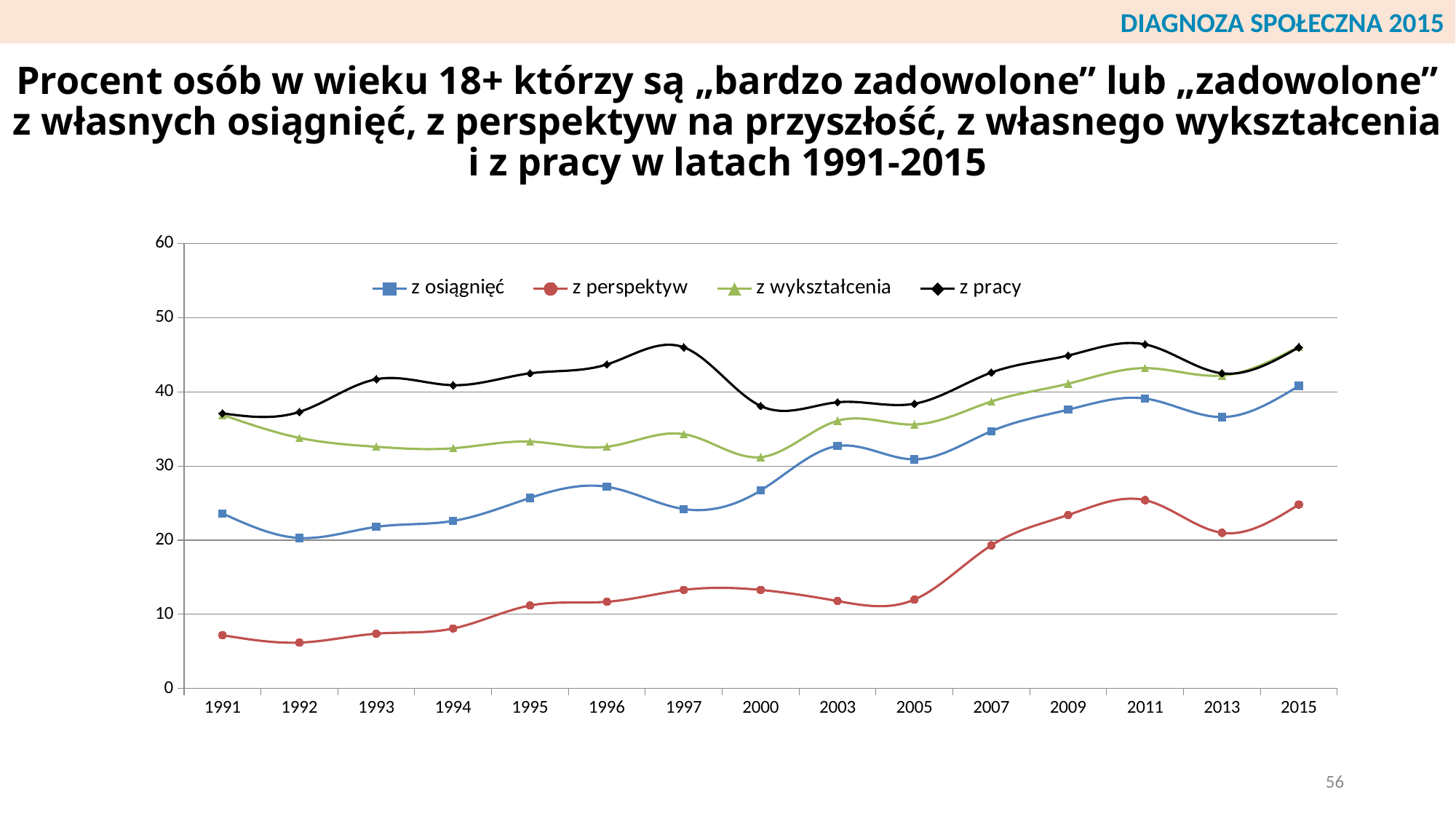
How many years are plotted along the x axis? 15 Does the value for "z perspektyw" rise or fall between 2005 and 2011? rise Which series is drawn with a black line and diamond markers? z pracy Is the value for "z perspektyw" in 2011 greater or less than 20? greater In 1995, which is larger: the value for "z wykształcenia" or the value for "z osiągnięć"? z wykształcenia How many series does the legend list? 4 Is the value for "z osiągnięć" in 1996 greater or less than 30? less Which series has the lowest value in 1991? z perspektyw Is the value for "z pracy" in 1997 greater or less than 40? greater Which series has the highest value in 2003? z pracy What kind of chart is shown on the slide? line chart